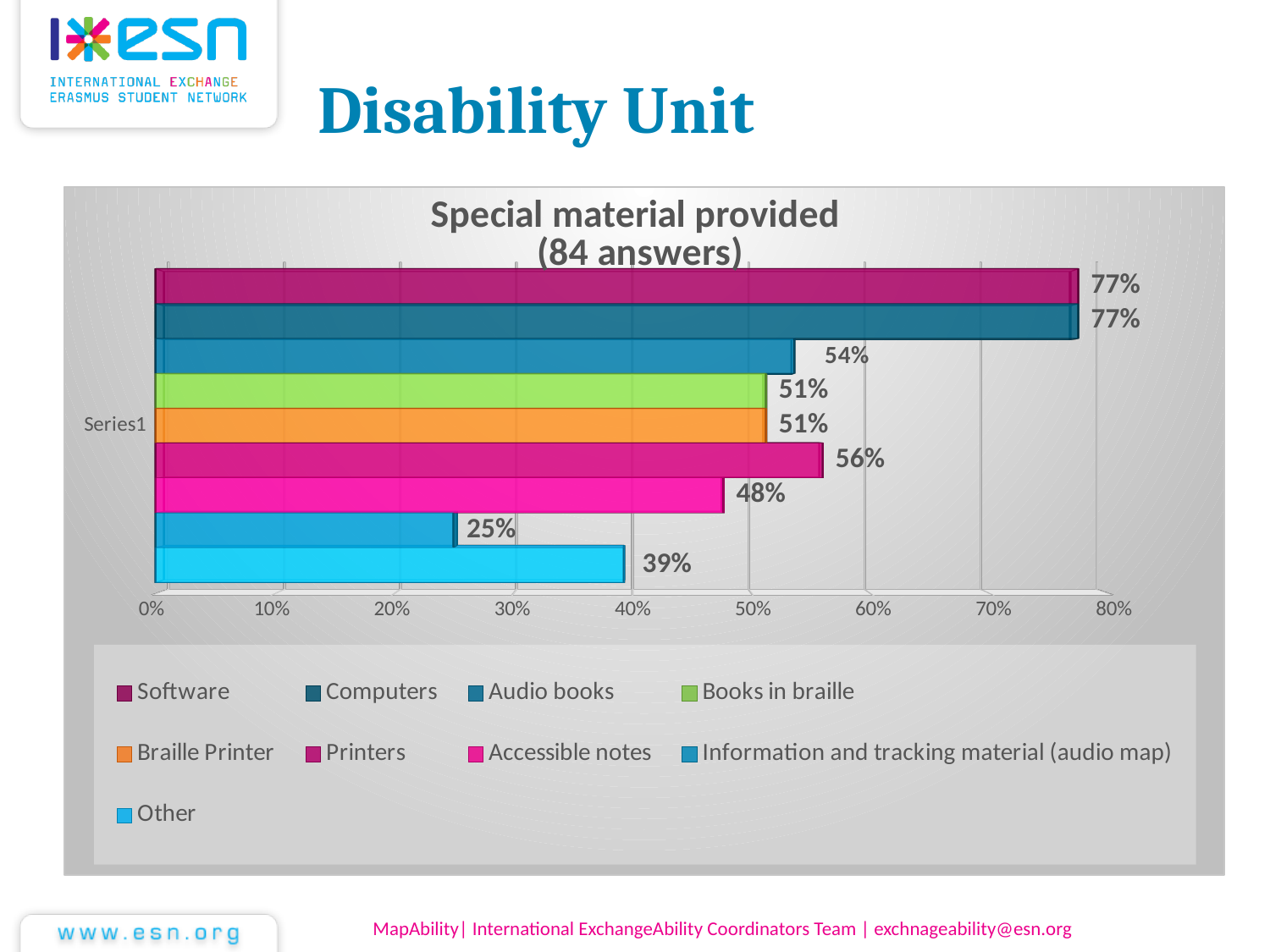
What is the difference between the percentages for Printers and Accessible notes? 8% What percentage is shown for Software? 77% Which item has the lowest percentage? Information and tracking material (audio map) What percentage is shown for Audio books? 54% What type of chart is shown on the slide? Bar chart What percentage is shown for Printers? 56% What percentage is shown for Other? 39% How many entries does the legend list? 9 What is the title of the chart? Special material provided (84 answers) Which is larger, the value for Audio books or the value for Other? Audio books Which two items share the highest percentage? Software and Computers What is the difference between the percentages for Computers and Information and tracking material (audio map)? 52%